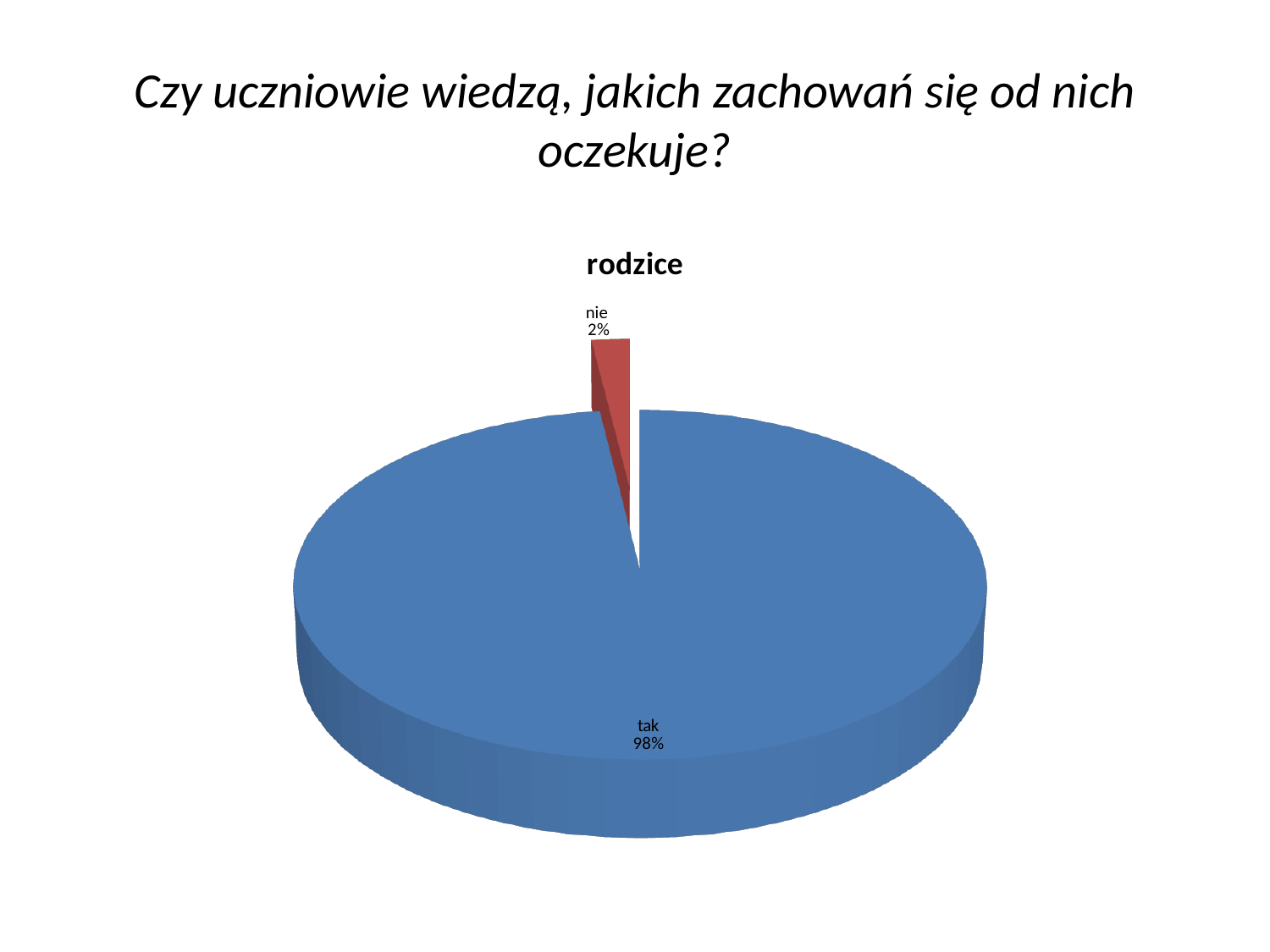
What share of the pie does the "nie" slice represent? 2% Which slice is larger, "tak" or "nie"? tak What is the title of the chart? rodzice Which slice is the largest in the pie chart? tak Which slice is the smallest in the pie chart? nie What share of the pie does the "tak" slice represent? 98% How many slices does the pie chart have? 2 What is the difference in percentage points between the "tak" and "nie" slices? 96 What colour is the "nie" slice? red What kind of chart is shown on the slide? pie chart